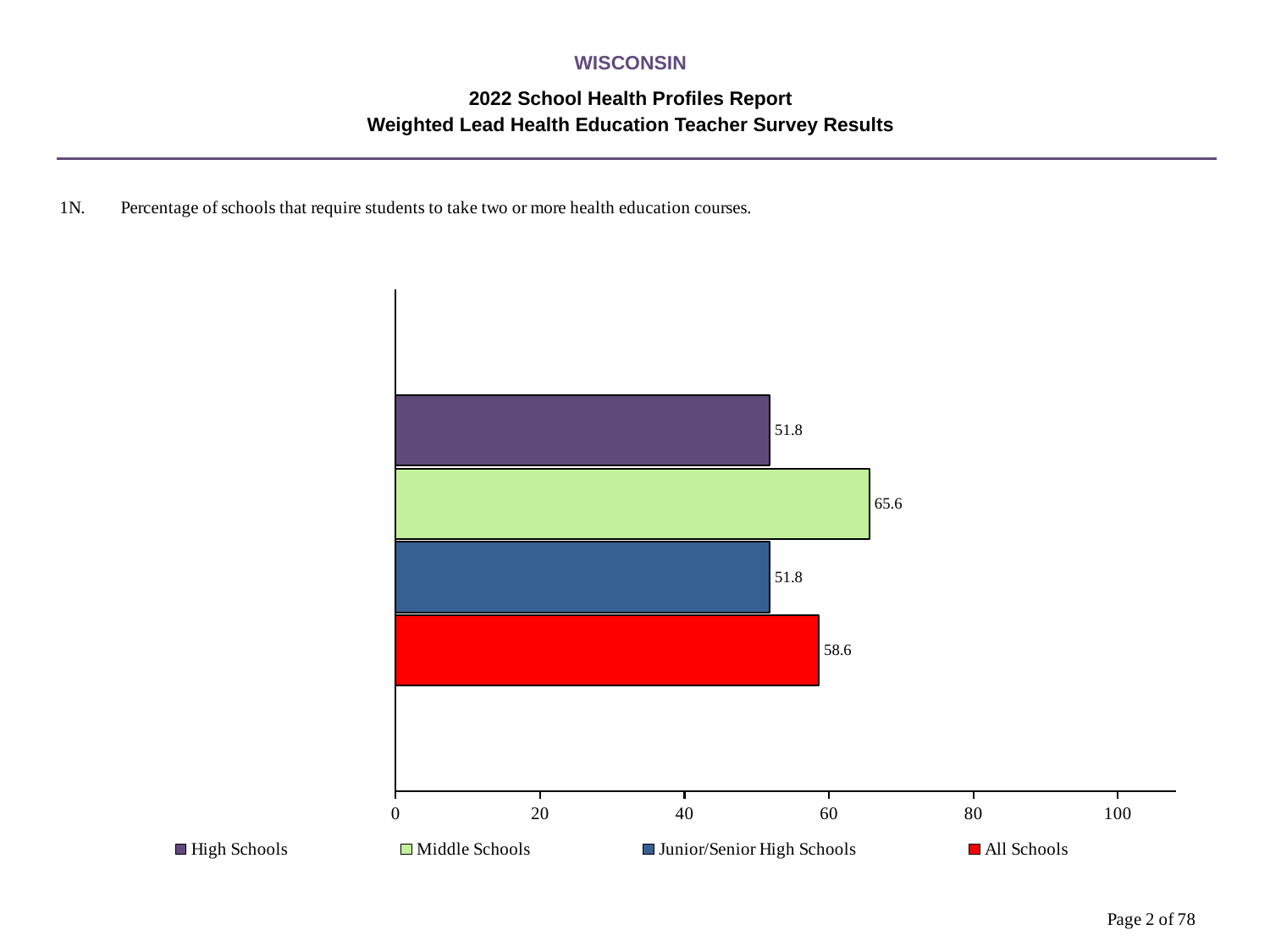
Which is larger, the value for Middle Schools or the value for All Schools? Middle Schools What is the difference between the Middle Schools value and the All Schools value? 7.0 What is the value for All Schools? 58.6 How many series does the legend list? 4 What colour is the bar for All Schools? red What is the value for Junior/Senior High Schools? 51.8 What is the difference between the Middle Schools value and the High Schools value? 13.8 What kind of chart is shown on the slide? bar chart Is the value for All Schools greater or less than 40? greater What is the value for Middle Schools? 65.6 What is the value for High Schools? 51.8 Which school type has the highest value? Middle Schools